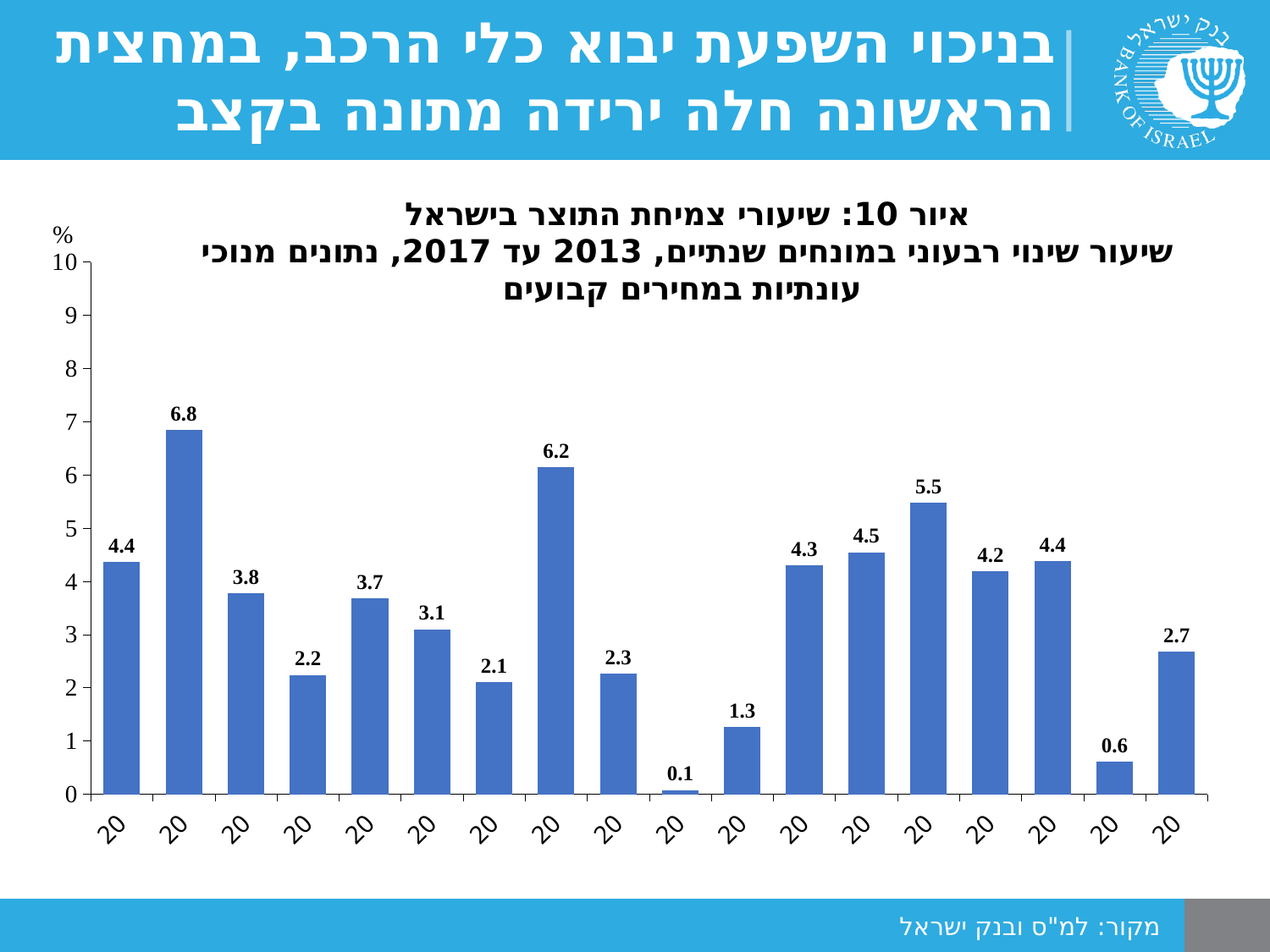
What is the lowest value shown in the chart? 0.1 Is the value of the second-to-last bar on the right greater or less than 1? less How many bars are plotted in the chart? 18 What type of chart is shown on the slide? bar chart What is the value of the first bar on the left of the chart? 4.4 What unit is indicated at the top of the vertical axis? % What is the highest value shown in the chart? 6.8 What is the maximum value shown on the vertical axis? 10 Which is larger, the second bar from the left (6.8) or the eighth bar from the left (6.2)? the second bar (6.8) What is the value of the last bar on the right of the chart? 2.7 What is the difference between the highest value (6.8) and the lowest value (0.1) in the chart? 6.7 What is the value of the second bar from the left? 6.8